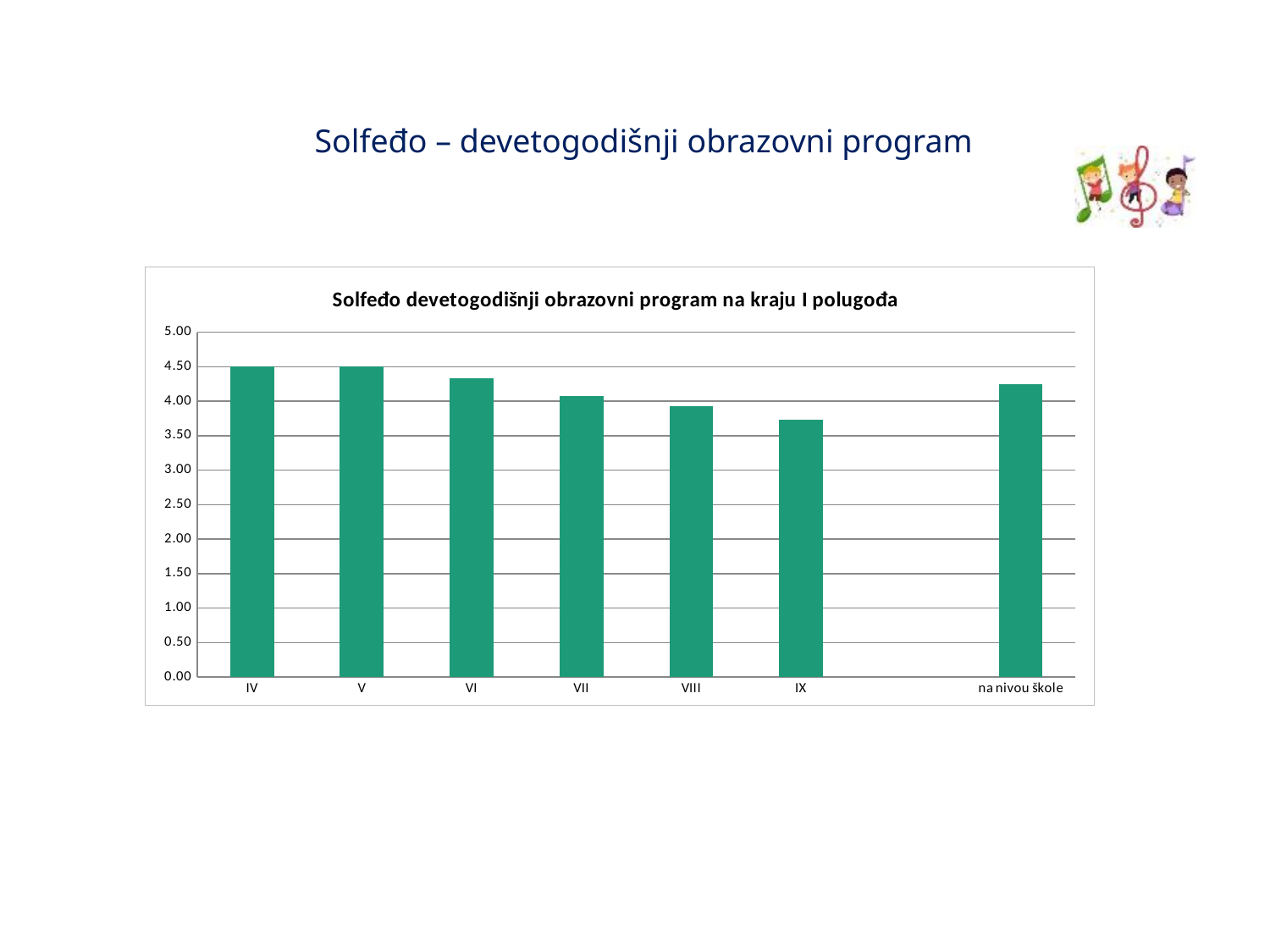
Do the values rise or fall from IV to IX along the x axis? fall Is the value for na nivou škole greater or less than 4.00? greater Which category has the lowest value in the chart? IX Is the value for IX greater or less than 3.50? greater Which is larger, the value for na nivou škole or the value for VIII? na nivou škole Is the value for IX greater or less than 4.00? less Which is larger, the value for VI or the value for IX? VI What is the title of the chart? Solfeđo devetogodišnji obrazovni program na kraju I polugođa What kind of chart is shown on the slide? bar chart How many categories are shown on the x axis of the chart? 7